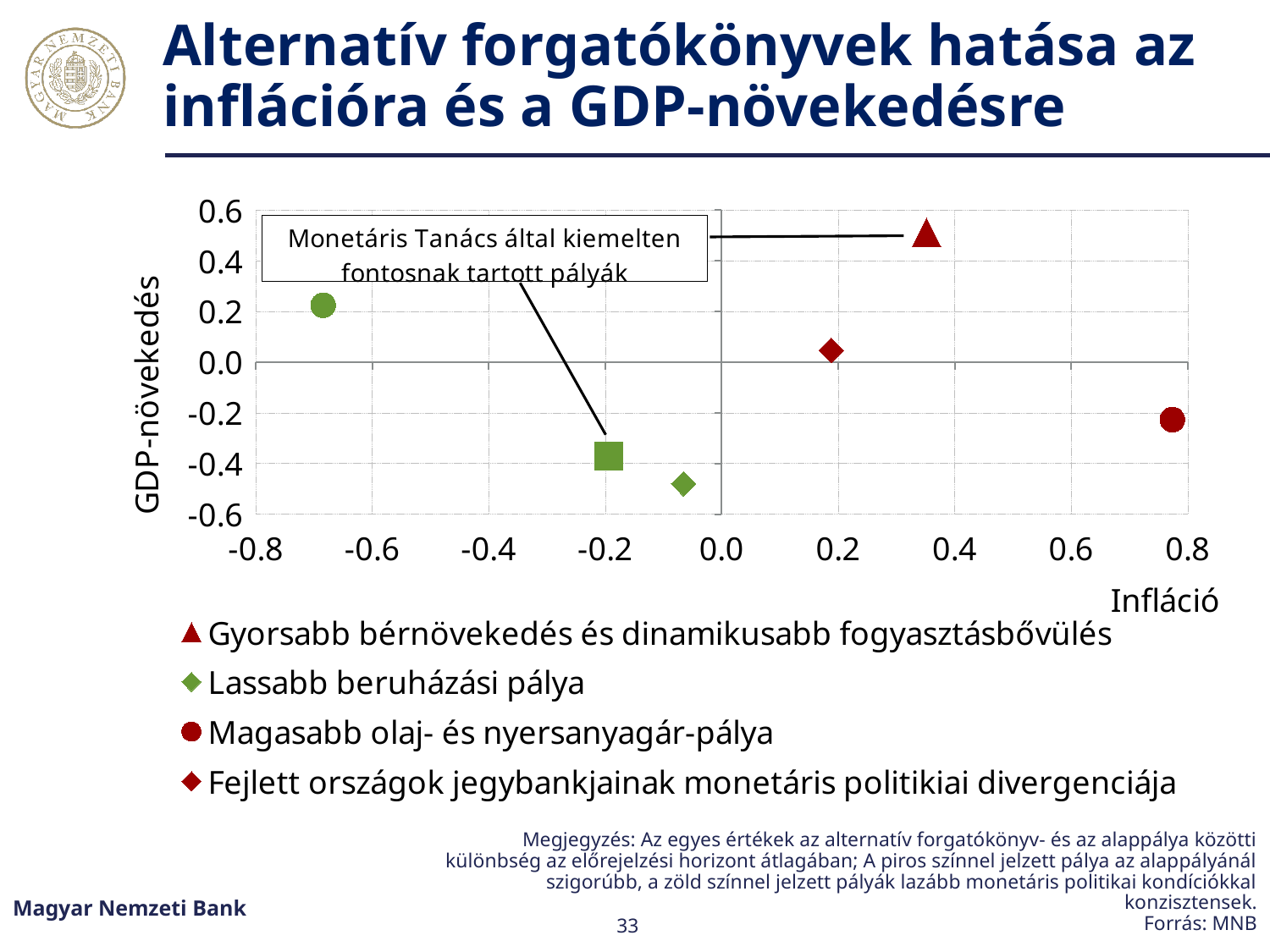
Which has the higher GDP-növekedés value: 'Gyorsabb bérnövekedés és dinamikusabb fogyasztásbővülés' or 'Magasabb olaj- és nyersanyagár-pálya'? Gyorsabb bérnövekedés és dinamikusabb fogyasztásbővülés Is the GDP-növekedés value for 'Gyorsabb bérnövekedés és dinamikusabb fogyasztásbővülés' greater or less than 0.4? greater What is the label of the vertical axis? GDP-növekedés Which legend series has the highest Infláció value? Magasabb olaj- és nyersanyagár-pálya Is the Infláció value for 'Gyorsabb bérnövekedés és dinamikusabb fogyasztásbővülés' greater or less than 0.2? greater Is the GDP-növekedés value for 'Fejlett országok jegybankjainak monetáris politikiai divergenciája' greater or less than 0.2? less How many series does the legend list? 4 What kind of chart is shown on the slide? scatter chart What is the label of the horizontal axis? Infláció How many data points are plotted in the chart? 6